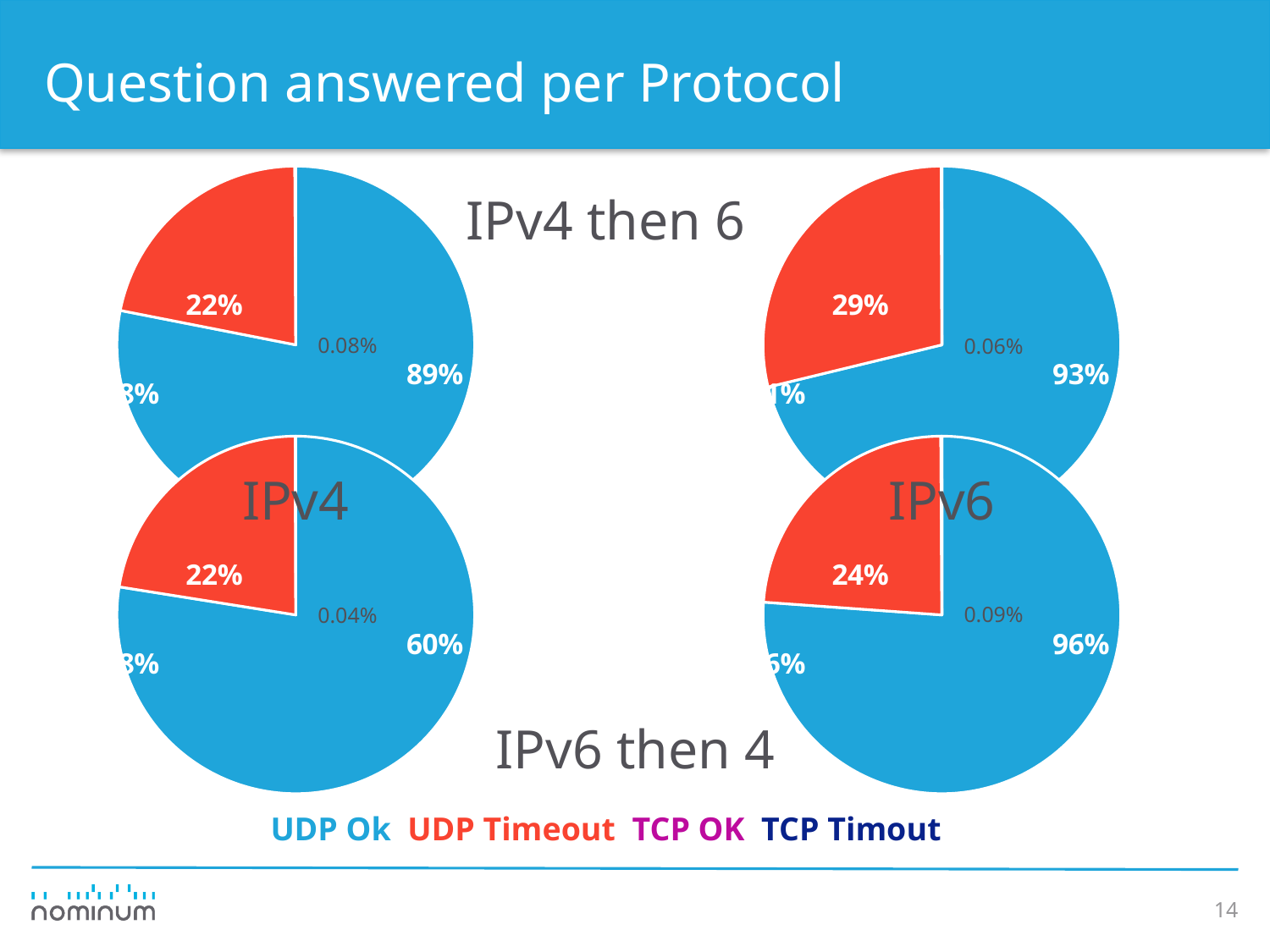
In the bottom-right pie chart, what is the small grey percentage label printed near the centre? 0.09% Which colour represents UDP Timeout in the legend? Red In the top-left pie chart, what is the small grey percentage label printed near the centre? 0.08% In the top-left pie chart, what percentage is printed on the red (UDP Timeout) slice? 22% How many entries does the legend at the bottom of the slide list? 4 What kind of charts are shown on the slide? Pie charts Which pie chart has the largest red (UDP Timeout) slice: the top-left or the top-right? Top-right In the top-right pie chart, what percentage is printed on the red (UDP Timeout) slice? 29% In the top-right pie chart, what is the small grey percentage label printed near the centre? 0.06% In the bottom-left pie chart, what is the small grey percentage label printed near the centre? 0.04% In the bottom-right pie chart, what percentage is printed on the red (UDP Timeout) slice? 24% In the bottom-left pie chart, what percentage is printed on the red (UDP Timeout) slice? 22%